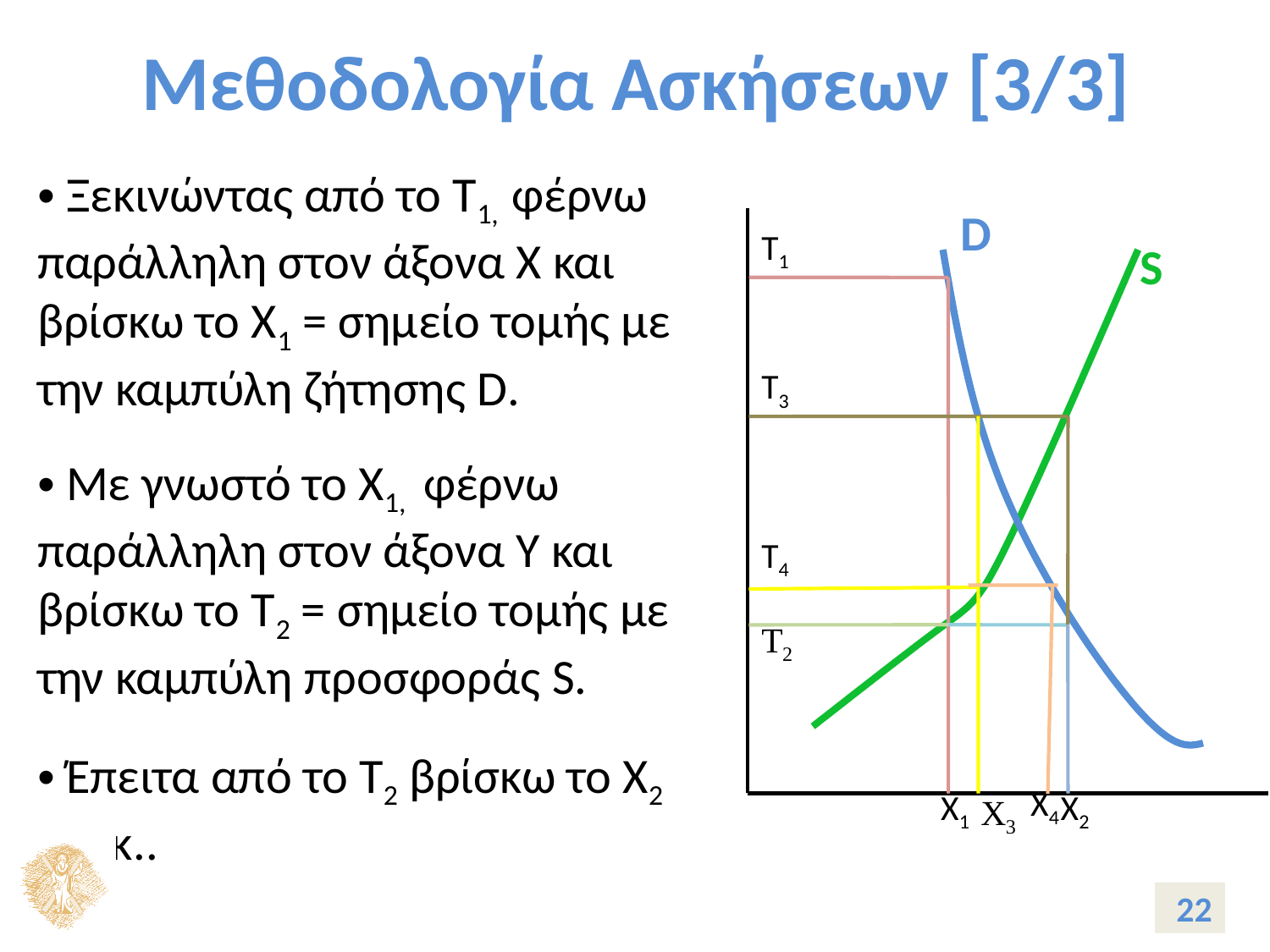
What are the labels of the two curves on the chart? D and S Does the curve labelled D rise or fall as it moves along the x axis? falls How many curves are plotted on the chart? 2 What kind of chart is shown on the slide? line chart Which is higher on the vertical axis, T1 or T3? T1 Which of the labelled T levels is the lowest on the vertical axis? T2 What colour is the curve labelled S? green Does the curve labelled S rise or fall as it moves along the x axis? rises Which is further right on the horizontal axis, X3 or X4? X4 Which of the labelled T levels is the highest on the vertical axis? T1 Which of the labelled X values is furthest to the left on the horizontal axis? X1 Which of the labelled X values is furthest to the right on the horizontal axis? X2